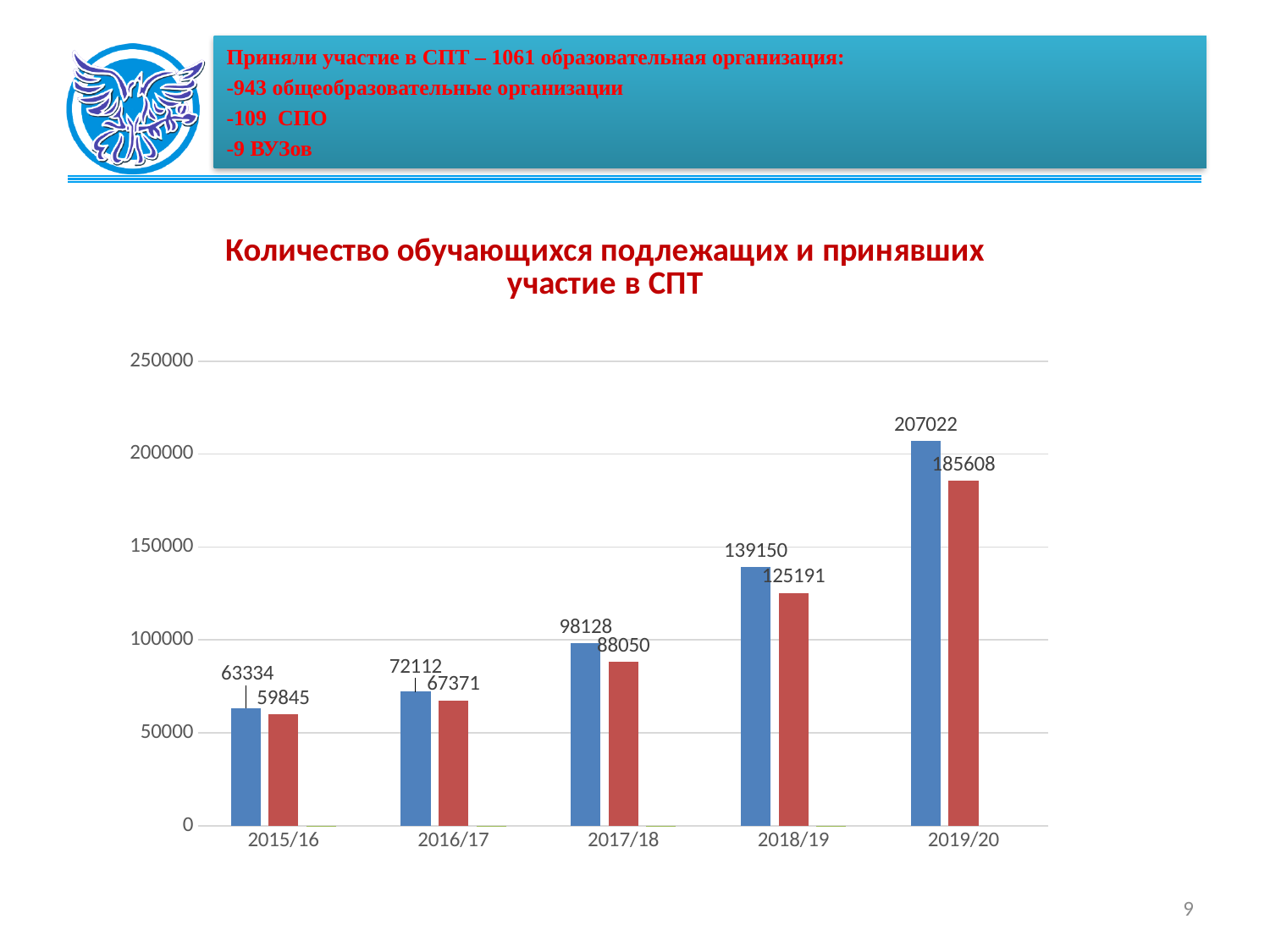
Do the blue bar values rise or fall from 2015/16 to 2019/20? rise Is the value of the red bar for 2018/19 greater or less than 100000? greater How many years are shown on the x axis? 5 What is the value of the red bar for 2017/18? 88050 What is the value of the blue bar for 2019/20? 207022 What is the value of the blue bar for 2015/16? 63334 Which year has the highest blue bar? 2019/20 What kind of chart is shown on the slide? bar chart Which is larger for 2016/17, the blue bar or the red bar? the blue bar Which year has the lowest red bar? 2015/16 What is the value of the red bar for 2018/19? 125191 What is the difference between the blue and red bars for 2019/20? 21414